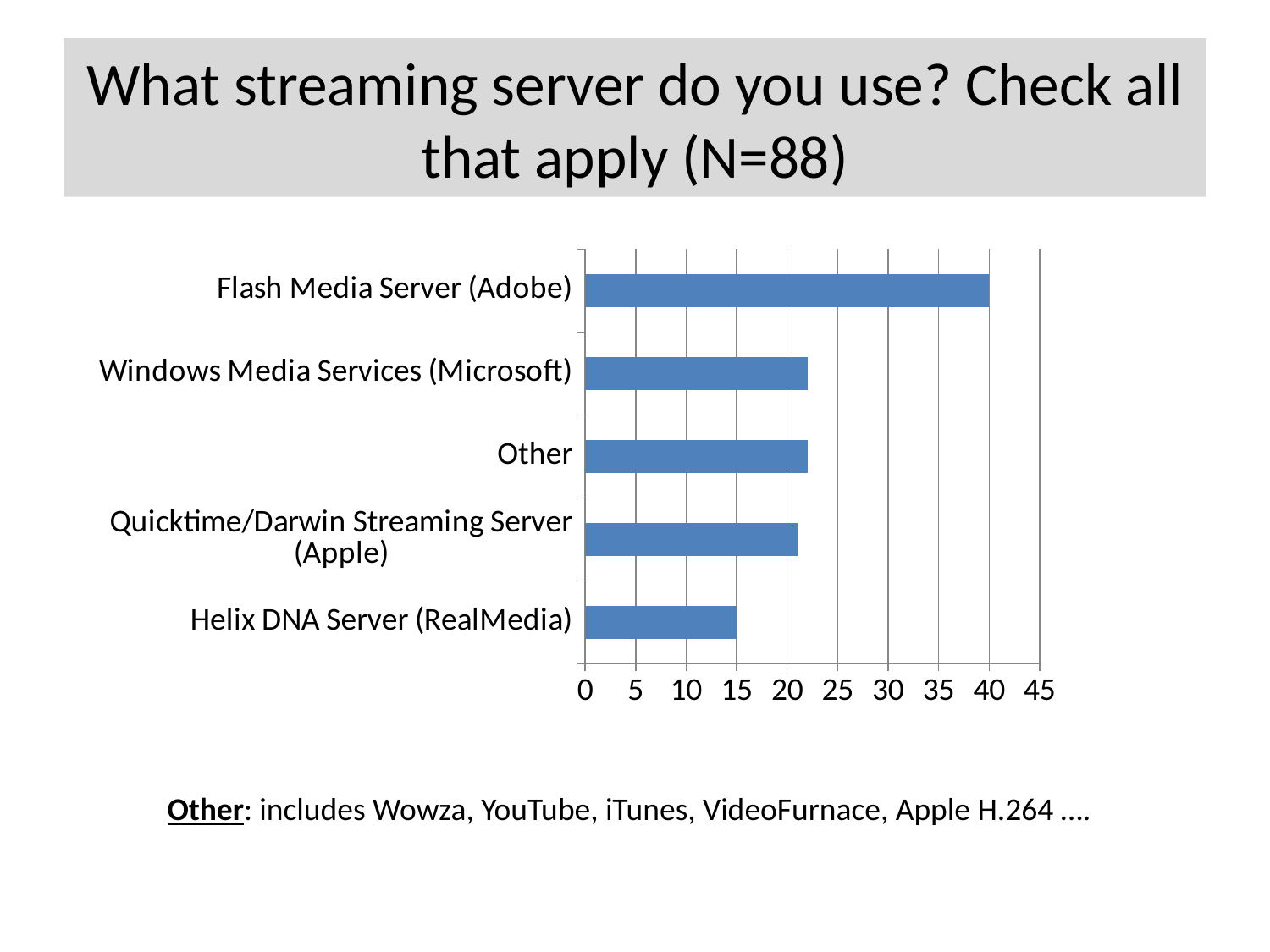
Is the value for Quicktime/Darwin Streaming Server (Apple) greater or less than 30? less Which streaming server has the lowest value in the chart? Helix DNA Server (RealMedia) What is the value for Helix DNA Server (RealMedia)? 15 Which has a larger value, Flash Media Server (Adobe) or Windows Media Services (Microsoft)? Flash Media Server (Adobe) What is the title of the slide containing the chart? What streaming server do you use? Check all that apply (N=88) Is the value for Windows Media Services (Microsoft) greater or less than 20? greater Is the value for Other greater or less than 25? less What is the value for Flash Media Server (Adobe)? 40 Which streaming server has the highest value in the chart? Flash Media Server (Adobe) What kind of chart is shown on the slide? bar chart Which has a larger value, Helix DNA Server (RealMedia) or Quicktime/Darwin Streaming Server (Apple)? Quicktime/Darwin Streaming Server (Apple) How many streaming server categories are plotted in the chart? 5